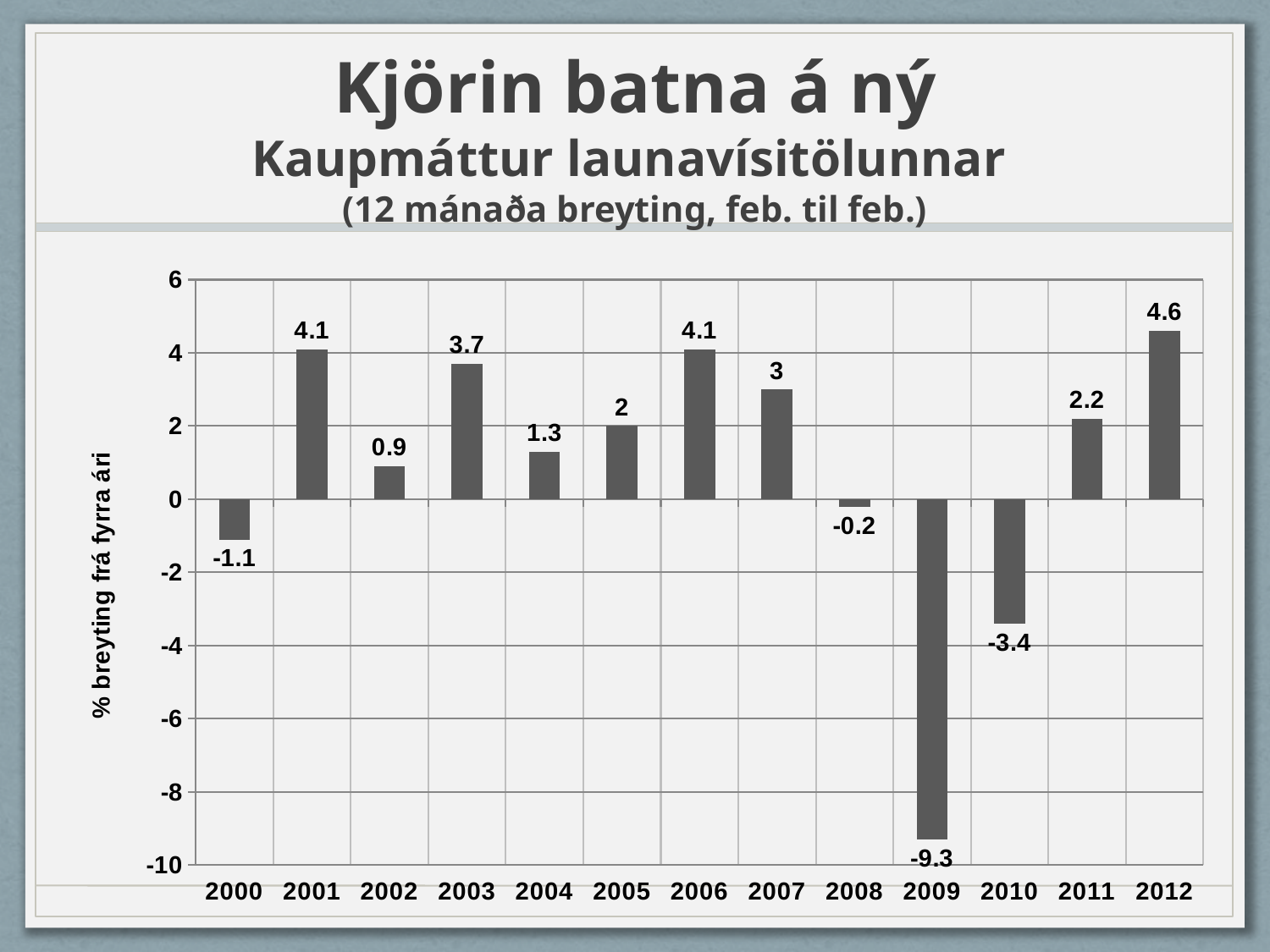
Which year has the lowest value? 2009 What kind of chart is shown on the slide? bar chart What is the difference between the values for 2012 and 2011? 2.4 How many years have a negative value? 4 Which is larger, the value for 2007 or the value for 2005? 2007 What is the label of the y axis? % breyting frá fyrra ári What is the value for 2012? 4.6 Which year has the highest value? 2012 What is the value for 2009? -9.3 Do the values rise or fall from 2009 to 2012? rise How many years are shown on the x axis? 13 What is the value for 2003? 3.7